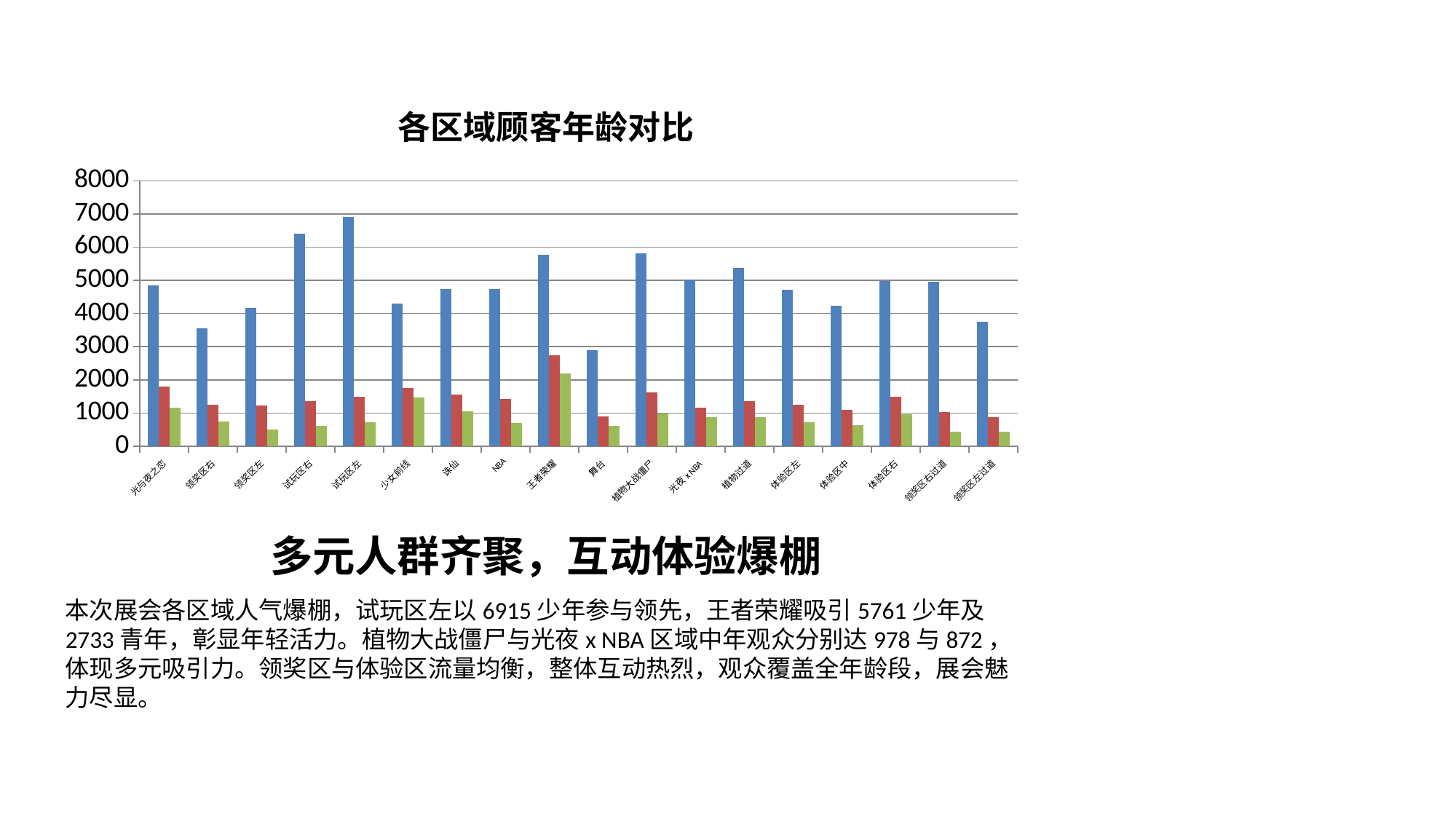
How many categories are shown along the x axis of the chart? 18 Is the red bar for 王者荣耀 greater or less than 2000? greater Which has the larger red bar, 王者荣耀 or 舞台? 王者荣耀 Is the blue bar for 试玩区左 greater or less than 6000? greater What kind of chart is shown on the slide? bar chart Which category has the tallest blue bar? 试玩区左 Which category has the tallest green bar? 王者荣耀 Which category has the tallest red bar? 王者荣耀 What is the title of the chart? 各区域顾客年龄对比 Which category has the shortest blue bar? 舞台 Which has the larger blue bar, 试玩区右 or 领奖区右? 试玩区右